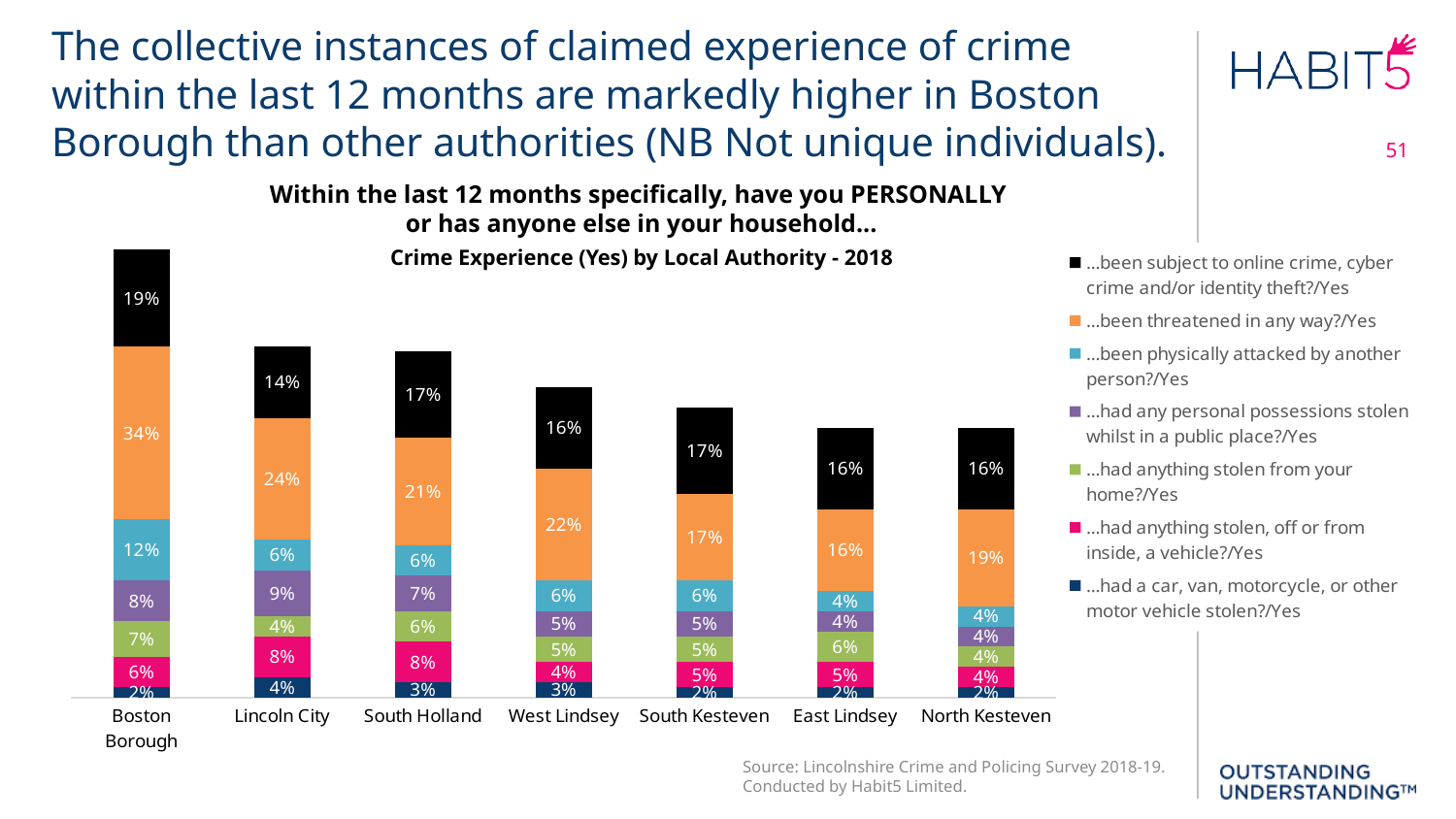
Which local authority has the highest value for having been threatened in any way? Boston Borough What percentage of respondents in Boston Borough said they had been threatened in any way? 34% How many local authorities are shown on the x axis? 7 What kind of chart is shown on the slide? Stacked bar chart What percentage of respondents in Boston Borough said they had been physically attacked by another person? 12% What is the title of the chart? Crime Experience (Yes) by Local Authority - 2018 What is the value for online crime, cyber crime and/or identity theft in Lincoln City? 14% How many series does the legend list? 7 What is the difference between the 'been threatened in any way' values for Boston Borough and Lincoln City? 10 percentage points What is the value for having anything stolen off or from inside a vehicle in Lincoln City? 8% Which is larger: the 'been threatened in any way' value for Boston Borough or for South Holland? Boston Borough What is the total of the stacked bar for Boston Borough? 88%